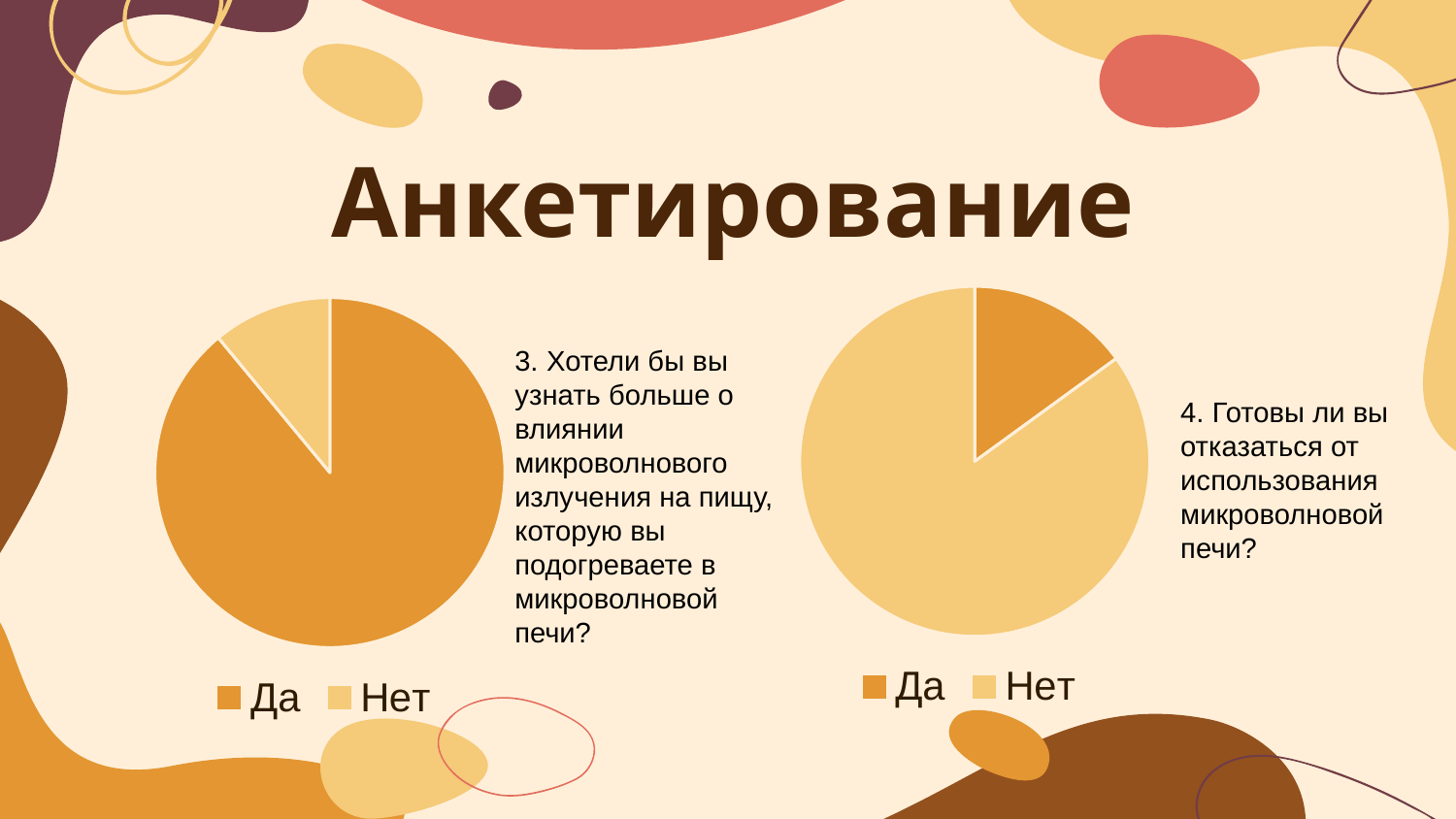
How many entries does the legend of the right pie chart list? 2 In the left pie chart, which category has the smallest slice? Нет In the left pie chart, which slice is larger, Да or Нет? Да How many slices does the left pie chart have? 2 What kind of chart is the right chart on the slide? pie chart In the right pie chart, what colour is the Нет slice? light yellow In the right pie chart, which slice is larger, Да or Нет? Нет In the left pie chart, which category has the largest slice? Да What kind of chart is the left chart on the slide? pie chart What are the legend entries of the left pie chart? Да, Нет In the right pie chart, which category has the largest slice? Нет In the right pie chart, which category has the smallest slice? Да